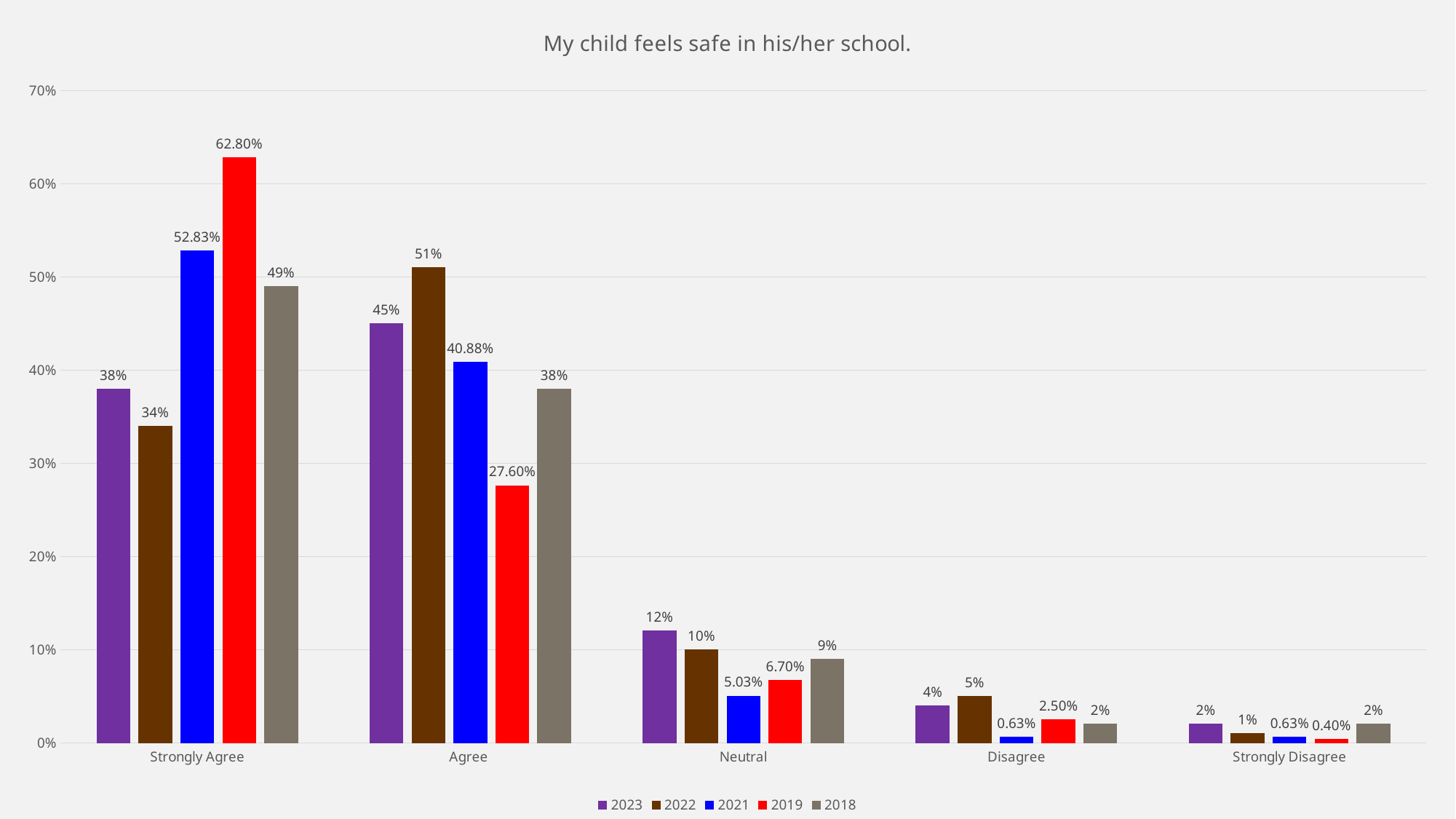
What is the value for 2021 in the Neutral category? 5.03% What kind of chart is shown on the slide? Bar chart How many categories are shown on the x axis? 5 What is the value for 2022 in the Agree category? 51% What is the difference between the 2023 and 2022 values in the Strongly Agree category? 4% Which is larger in the Neutral category, the value for 2023 or the value for 2018? 2023 What is the value for 2018 in the Disagree category? 2% Which year has the lowest value in the Agree category? 2019 What is the value for 2019 in the Strongly Agree category? 62.80% Which year has the highest value in the Strongly Agree category? 2019 How many series does the legend list? 5 Is the value for 2021 in the Strongly Agree category greater or less than 50%? greater